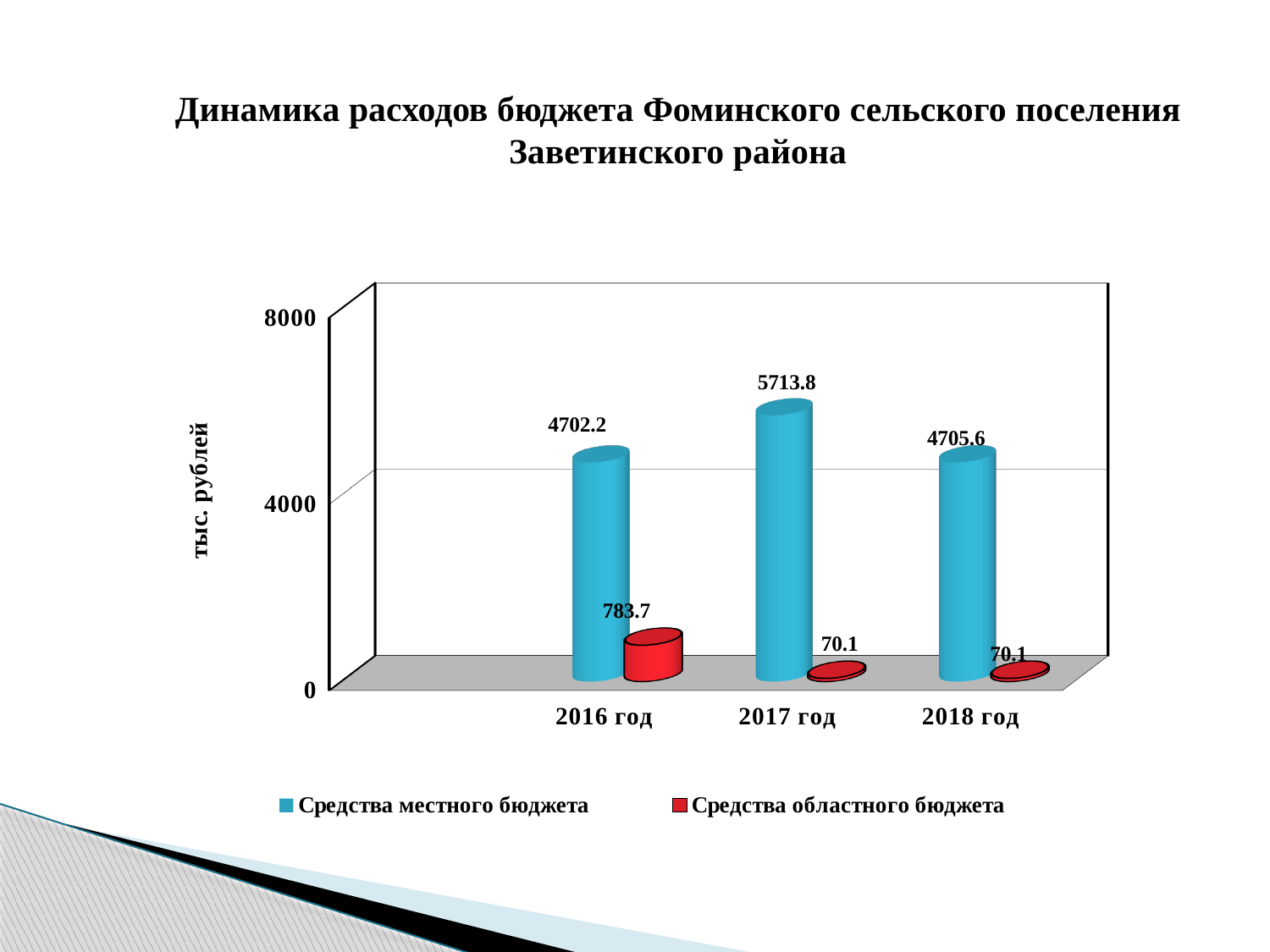
What kind of chart is shown on the slide? bar chart In which year is Средства областного бюджета highest? 2016 год Which is larger: Средства местного бюджета in 2018 год or in 2016 год? 2018 год Is the value for Средства местного бюджета in 2016 год greater or less than 4000? greater What is the value for Средства областного бюджета in 2016 год? 783.7 How many series does the legend list? 2 What is the value for Средства местного бюджета in 2018 год? 4705.6 What is the difference between Средства областного бюджета in 2016 год and 2017 год? 713.6 How many years are shown on the x axis? 3 What is the value for Средства местного бюджета in 2017 год? 5713.8 What is the difference between Средства местного бюджета in 2017 год and 2016 год? 1011.6 In which year is Средства местного бюджета highest? 2017 год